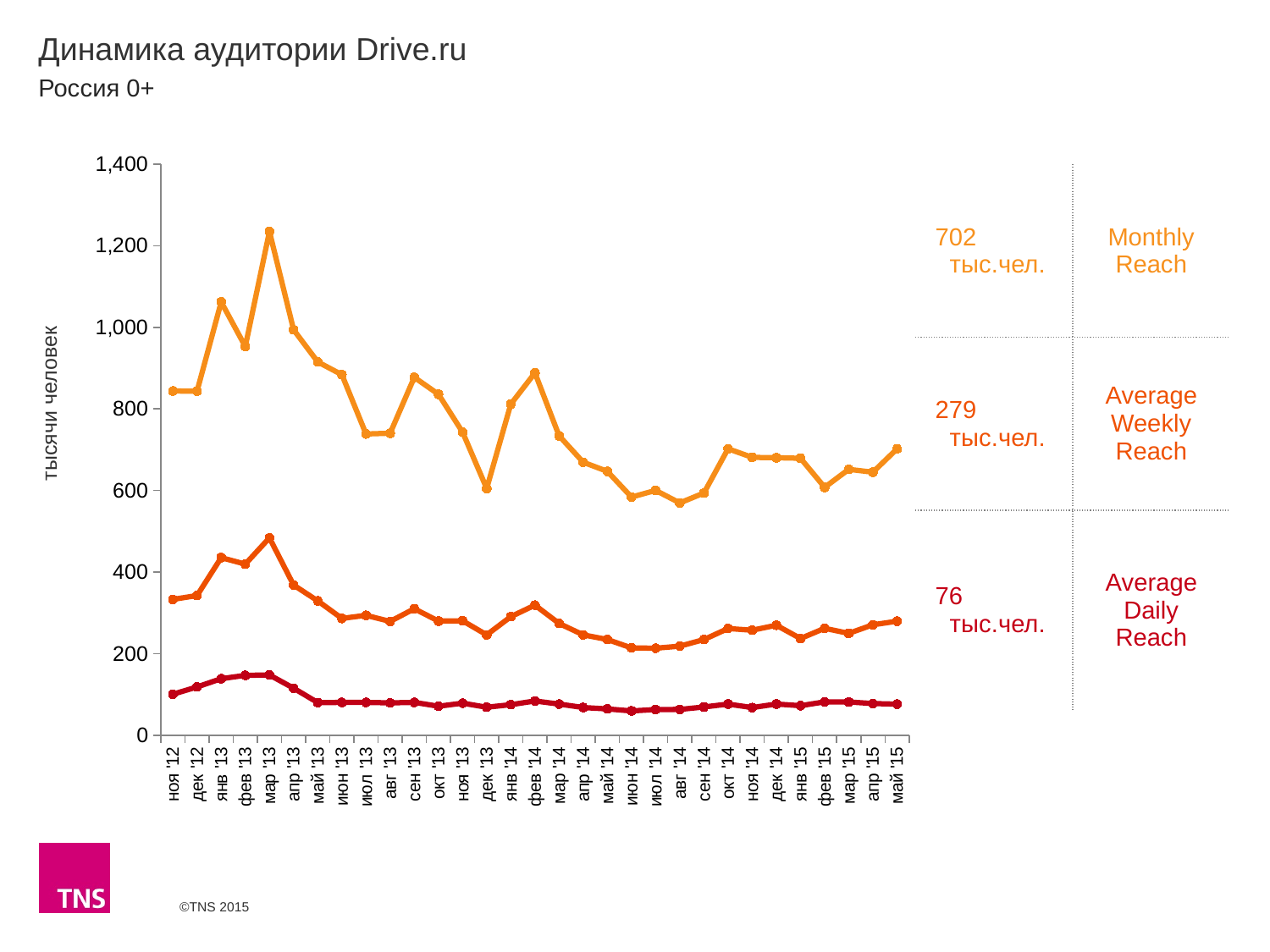
Which month has the higher Monthly Reach, янв '13 or фев '13? янв '13 What kind of chart is shown on the slide? line chart What is the Average Weekly Reach value for май '15? 279 тыс.чел. How many series (lines) are plotted on the chart? 3 Is the Monthly Reach value for дек '13 greater or less than 800? less Does the Monthly Reach line rise or fall from мар '13 to дек '13? fall Is the Monthly Reach value for мар '13 greater or less than 1,200? greater What is the label on the vertical axis of the chart? тысячи человек In which month does the Monthly Reach line reach its highest point? мар '13 What is the Average Daily Reach value for май '15? 76 тыс.чел. What is the Monthly Reach value for май '15? 702 тыс.чел. Is the Average Weekly Reach value for мар '13 greater or less than 400? greater